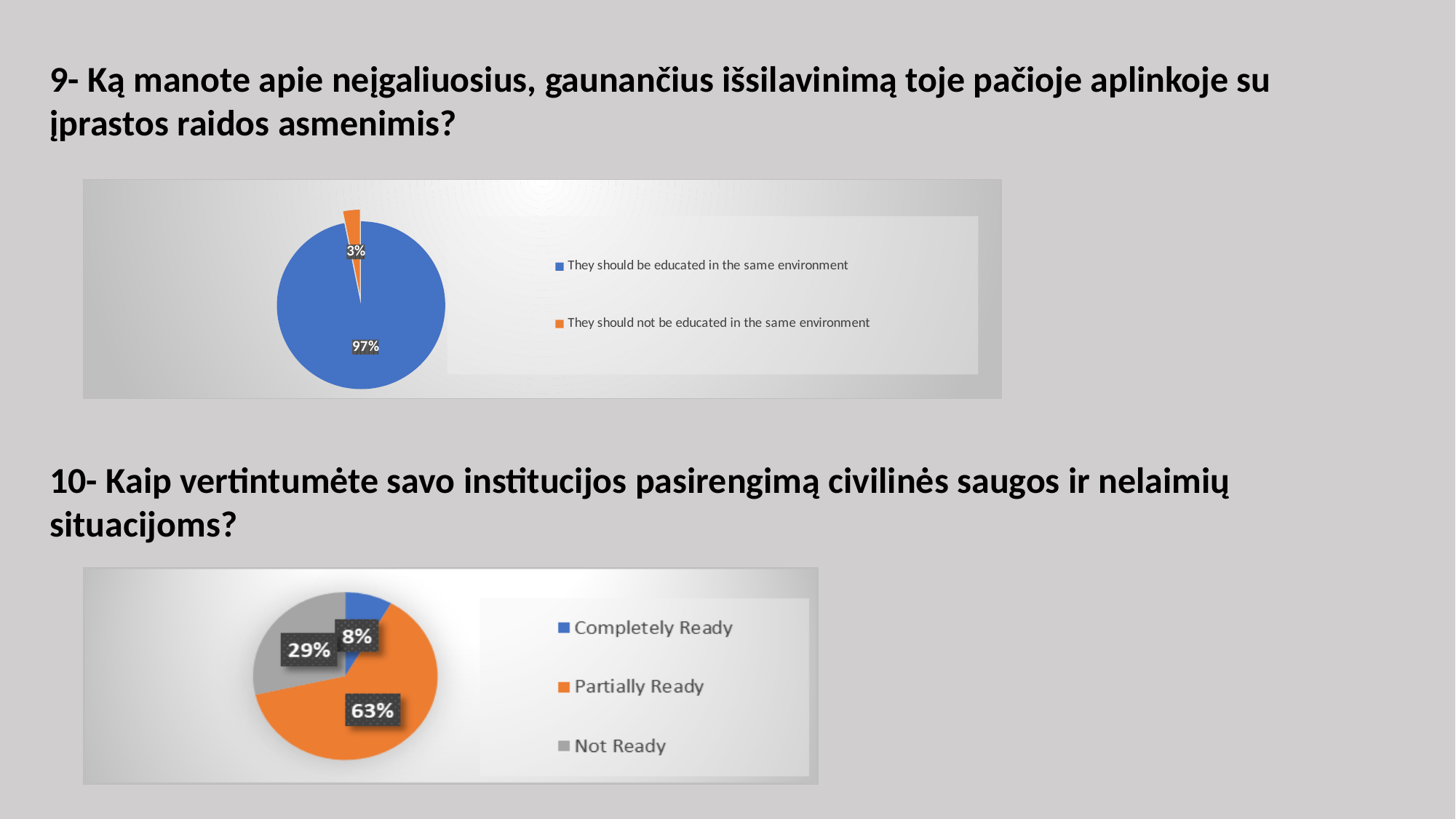
What type of chart is shown under question 9? Pie chart In the bottom pie chart (question 10), which colour represents Not Ready? Grey In the bottom pie chart (question 10), what share of respondents said Completely Ready? 8% In the top pie chart (question 9), what share of respondents said they should be educated in the same environment? 97% In the bottom pie chart (question 10), which category has the smallest share? Completely Ready In the bottom pie chart (question 10), what share of respondents said Not Ready? 29% In the bottom pie chart (question 10), what share of respondents said Partially Ready? 63% How many entries does the legend of the top chart (question 9) list? 2 In the bottom pie chart (question 10), how many categories are shown? 3 In the top pie chart (question 9), what is the difference in percentage points between the two responses? 94 In the top pie chart (question 9), which response has the largest share? They should be educated in the same environment In the top pie chart (question 9), what share of respondents said they should not be educated in the same environment? 3%